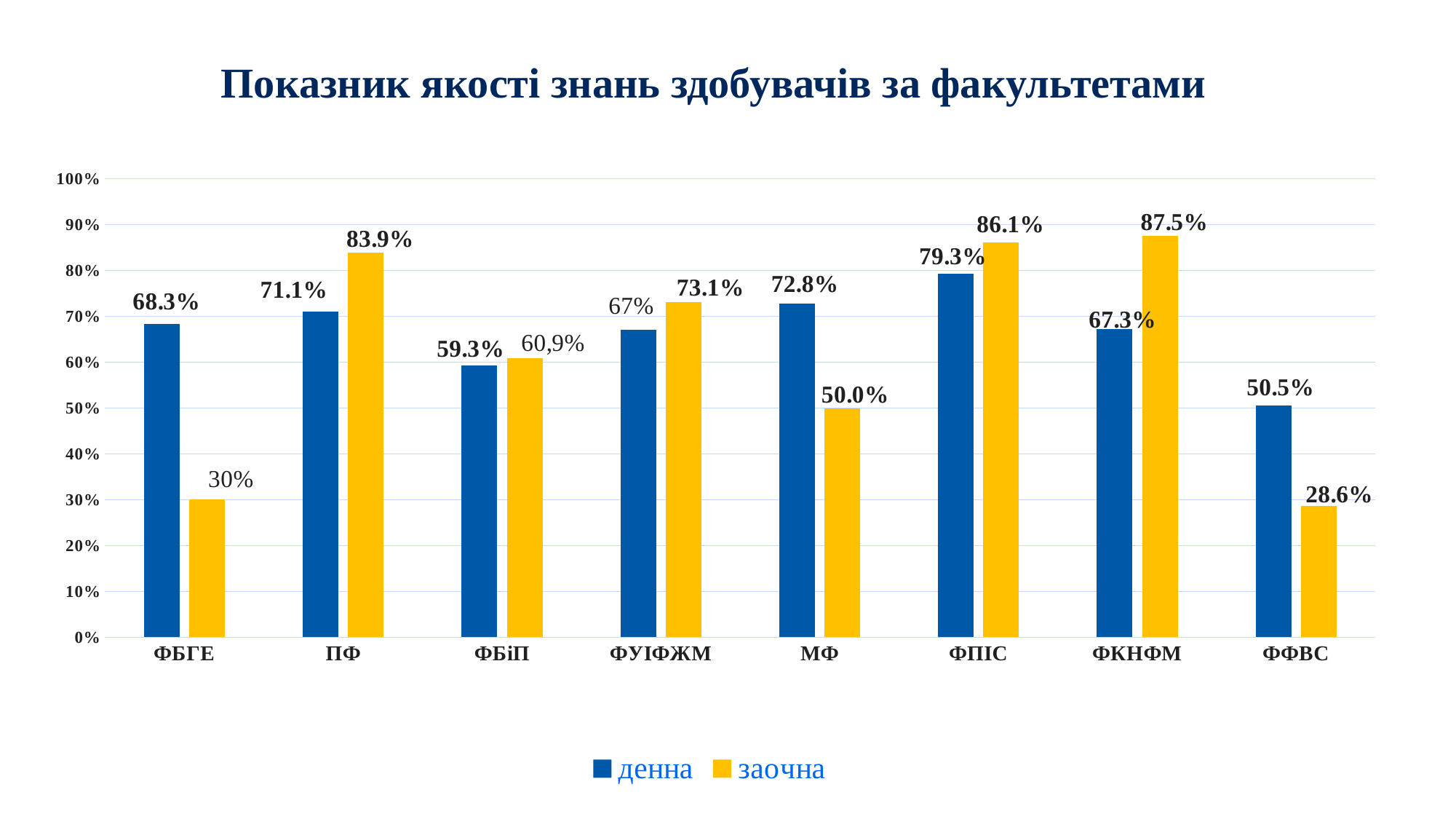
Which is larger for МФ: the денна value or the заочна value? денна Which faculty has the lowest заочна value? ФФВС How many faculties are shown on the x axis? 8 How many series does the legend list? 2 What is the денна value for ФПІС? 79.3% What is the difference between the заочна and денна values for ПФ? 12.8% What is the заочна value for ФКНФМ? 87.5% What is the title of the chart? Показник якості знань здобувачів за факультетами Which faculty has the highest денна value? ФПІС Which colour represents the заочна series? yellow What is the заочна value for ФБГЕ? 30% What kind of chart is shown on the slide? bar chart